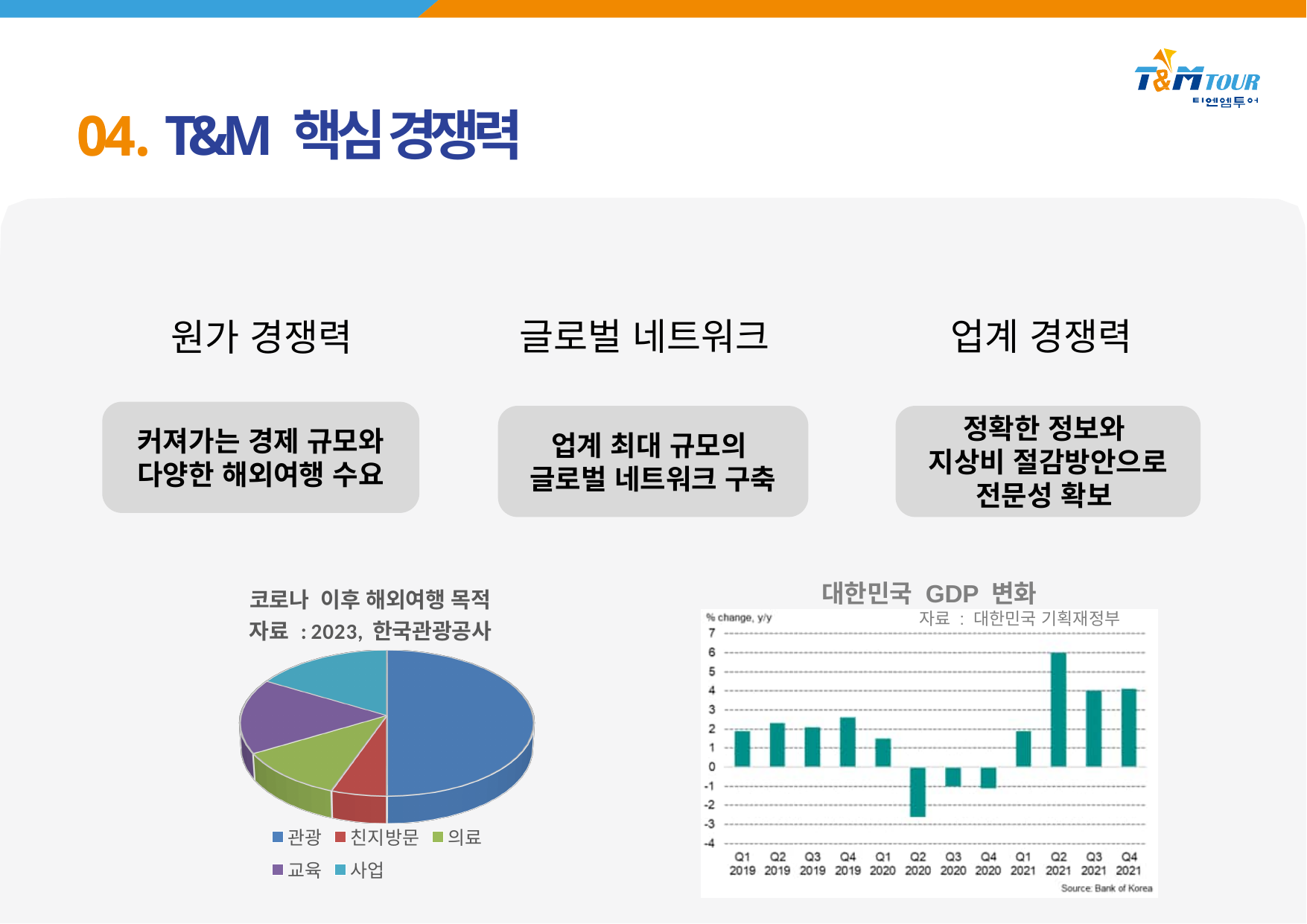
What kind of chart is the '대한민국 GDP 변화' chart on the right? bar chart In the '코로나 이후 해외여행 목적' pie chart, which category has the smallest slice? 친지방문 How many quarterly bars are plotted in the '대한민국 GDP 변화' chart? 12 In the '코로나 이후 해외여행 목적' pie chart, which category has the largest slice? 관광 In the '코로나 이후 해외여행 목적' pie chart, which slice is larger, 관광 or 교육? 관광 In the '대한민국 GDP 변화' chart, which quarter has the lowest value? Q2 2020 How many categories does the legend of the '코로나 이후 해외여행 목적' pie chart list? 5 What kind of chart is the '코로나 이후 해외여행 목적' chart on the left? pie chart What source is cited at the bottom right of the '대한민국 GDP 변화' chart? Bank of Korea In the '대한민국 GDP 변화' chart, is the value for Q2 2021 greater or less than 5? greater In the '대한민국 GDP 변화' chart, which quarter has the highest value? Q2 2021 In the '대한민국 GDP 변화' chart, is the value for Q2 2020 greater or less than -2? less